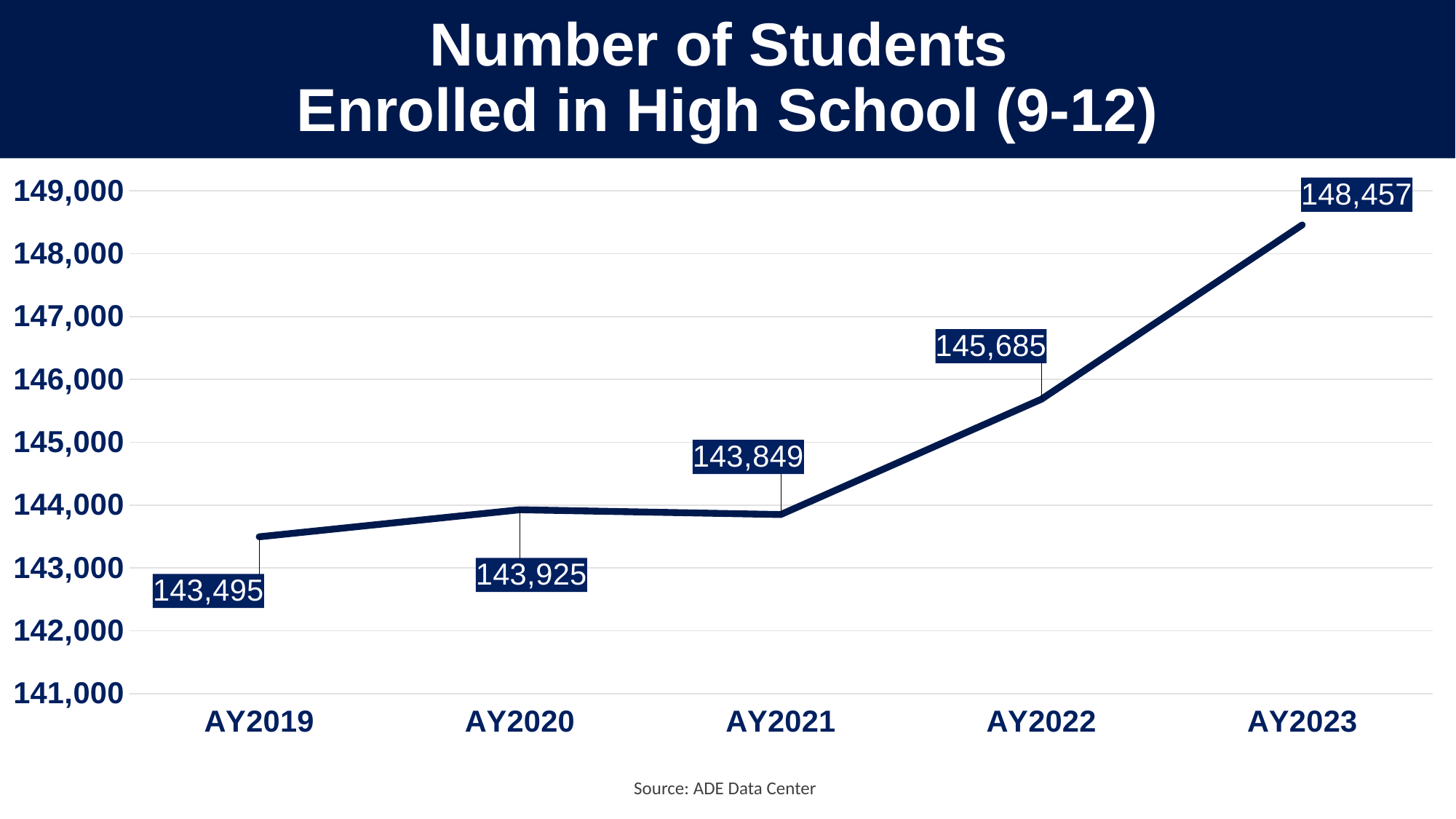
What is the number of students enrolled in high school in AY2019? 143,495 Which academic year has the lowest number of students enrolled in high school? AY2019 What is the difference in enrollment between AY2023 and AY2022? 2,772 Which academic year has the highest number of students enrolled in high school? AY2023 What is the number of students enrolled in high school in AY2021? 143,849 What is the difference in enrollment between AY2020 and AY2019? 430 What kind of chart is shown on the slide? line chart What is the number of students enrolled in high school in AY2023? 148,457 What is the source cited for the chart data? ADE Data Center How many academic years are plotted on the chart? 5 Which year has higher enrollment, AY2020 or AY2021? AY2020 Is the enrollment for AY2022 greater or less than 145,000? greater